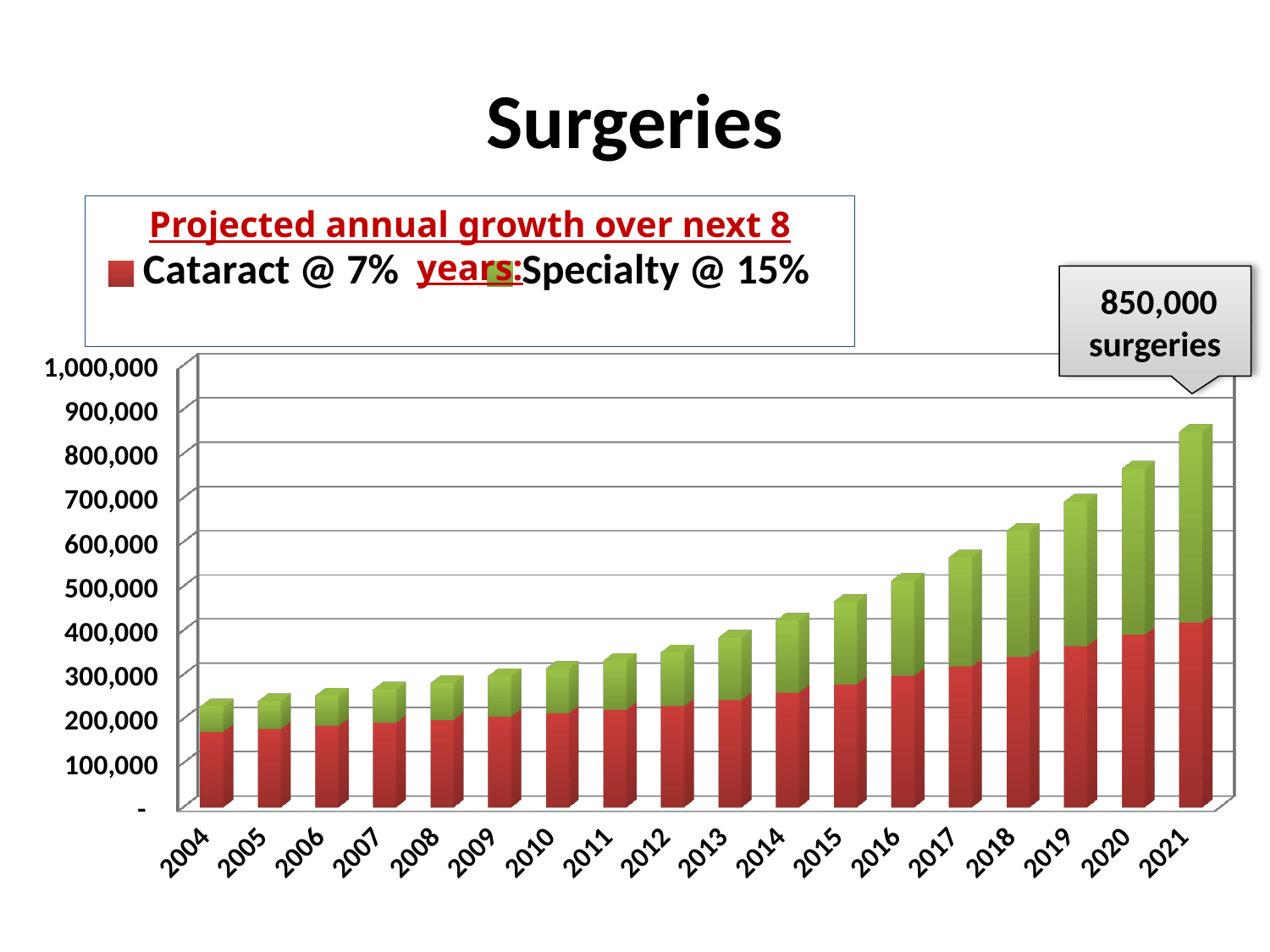
Do total surgeries rise or fall from 2004 to 2021? Rise Is the total for 2012 greater or less than 400,000? less Is the total for 2018 greater or less than 600,000? greater How many years are shown along the x axis of the Surgeries chart? 18 Is the total for 2004 greater or less than 200,000? greater Which series is shown in red in the Surgeries chart? Cataract @ 7% Which year has the highest total surgeries? 2021 What kind of chart is shown on the slide? Stacked bar chart Which year has a larger total of surgeries, 2015 or 2020? 2020 Which year has the lowest total surgeries? 2004 According to the callout, what is the total number of surgeries in 2021? 850,000 surgeries How many series does the legend of the Surgeries chart list? 2